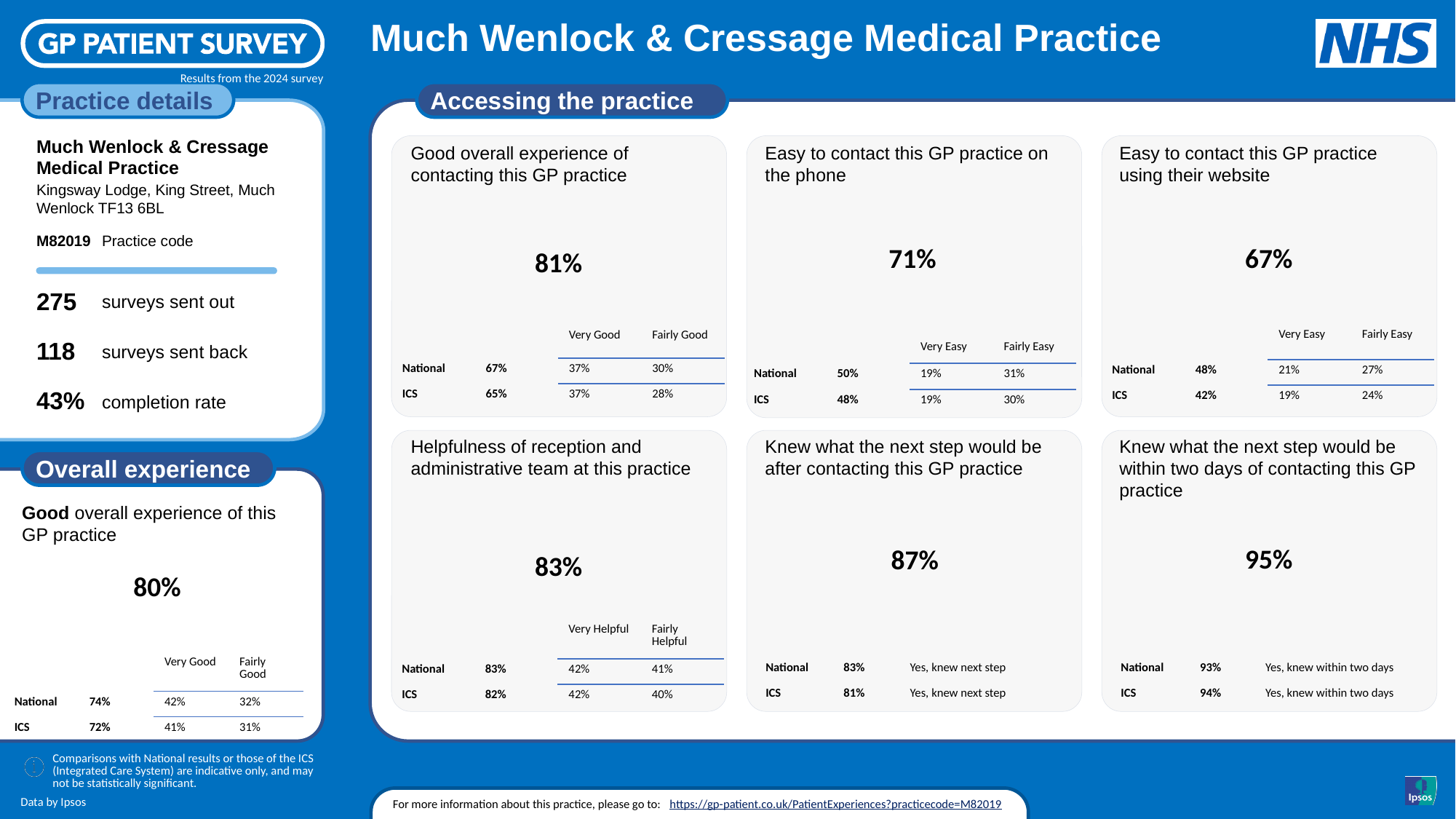
In the 'Good overall experience of this GP practice' panel, what is the practice's headline percentage? 80% In the 'Knew what the next step would be after contacting this GP practice' panel, what is the difference between the practice's headline percentage and the National figure? 4% In the 'Easy to contact this GP practice on the phone' panel, is the practice's headline percentage higher or lower than the National figure? higher Among the six 'Accessing the practice' panels, which has the highest headline percentage? Knew what the next step would be within two days of contacting this GP practice In the 'Easy to contact this GP practice using their website' panel, what is the National figure? 48% How many panels are shown in the 'Accessing the practice' section? 6 In the 'Helpfulness of reception and administrative team at this practice' panel, what is the ICS figure? 82% In the 'Easy to contact this GP practice on the phone' panel, what is the practice's headline percentage? 71% In the 'Good overall experience of contacting this GP practice' panel, what is the practice's headline percentage? 81% In the 'Knew what the next step would be within two days of contacting this GP practice' panel, what is the practice's headline percentage? 95% In the 'Good overall experience of this GP practice' panel, what is the National 'Very Good' percentage? 42% Among the six 'Accessing the practice' panels, which has the lowest headline percentage? Easy to contact this GP practice using their website